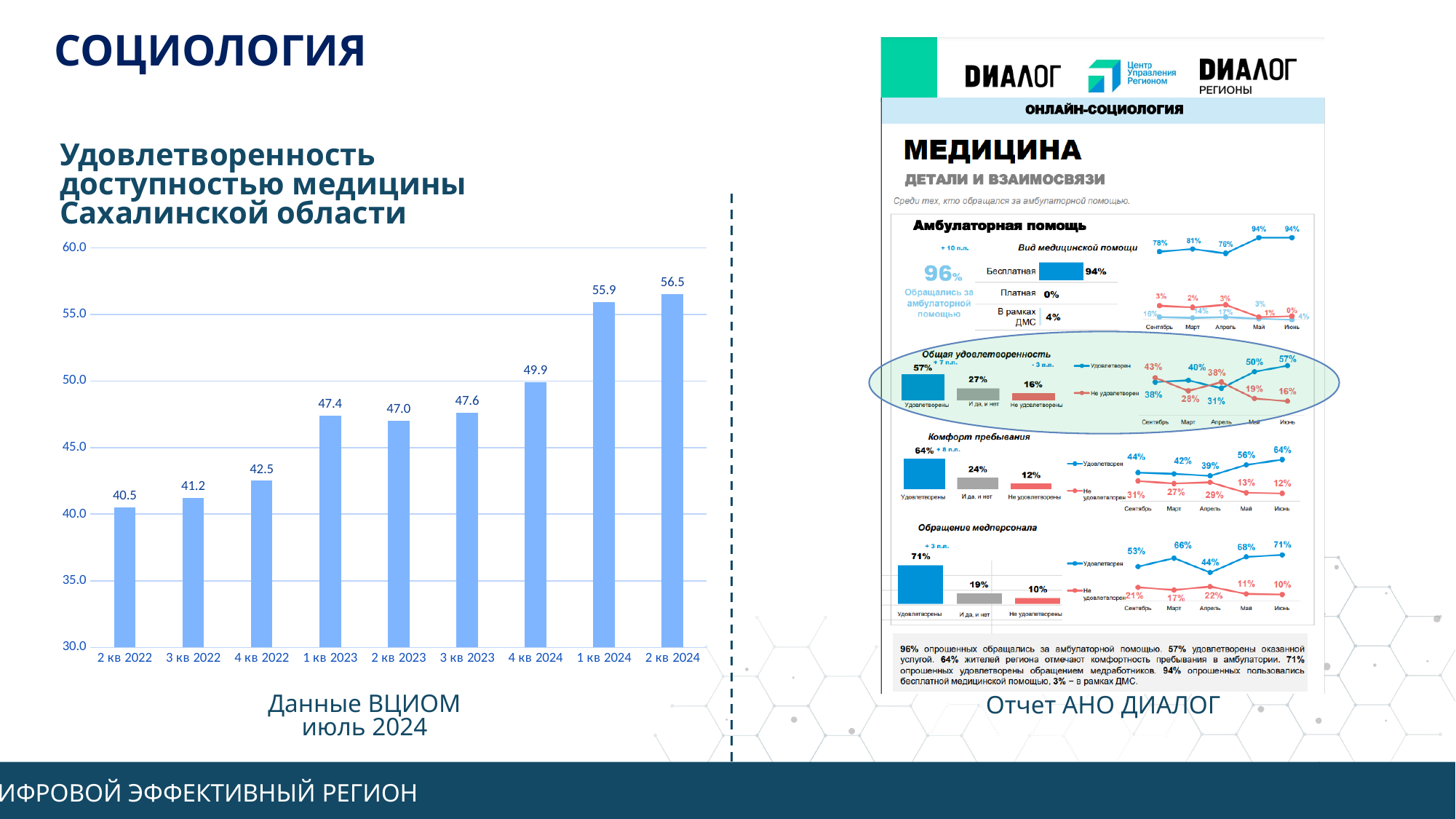
According to the caption under the bar chart on the left, what is the data source? Данные ВЦИОМ июль 2024 In the bar chart 'Удовлетворенность доступностью медицины Сахалинской области', do the values generally rise or fall from 2 кв 2022 to 2 кв 2024? rise In the bar chart 'Удовлетворенность доступностью медицины Сахалинской области', which is larger: the value for 2 кв 2023 or 3 кв 2023? 3 кв 2023 In the bar chart 'Удовлетворенность доступностью медицины Сахалинской области', which quarter has the highest value? 2 кв 2024 What type of chart is 'Удовлетворенность доступностью медицины Сахалинской области'? bar chart In the bar chart 'Удовлетворенность доступностью медицины Сахалинской области', which quarter has the lowest value? 2 кв 2022 In the bar chart 'Удовлетворенность доступностью медицины Сахалинской области', what is the value for 4 кв 2022? 42.5 In the bar chart 'Удовлетворенность доступностью медицины Сахалинской области', what is the value for 2 кв 2024? 56.5 How many quarters are shown in the bar chart 'Удовлетворенность доступностью медицины Сахалинской области'? 9 In the bar chart 'Удовлетворенность доступностью медицины Сахалинской области', is the value for 4 кв 2024 greater or less than 50.0? less In the bar chart 'Удовлетворенность доступностью медицины Сахалинской области', what is the difference between the values for 2 кв 2024 and 2 кв 2022? 16.0 In the bar chart 'Удовлетворенность доступностью медицины Сахалинской области', what is the value for 1 кв 2023? 47.4